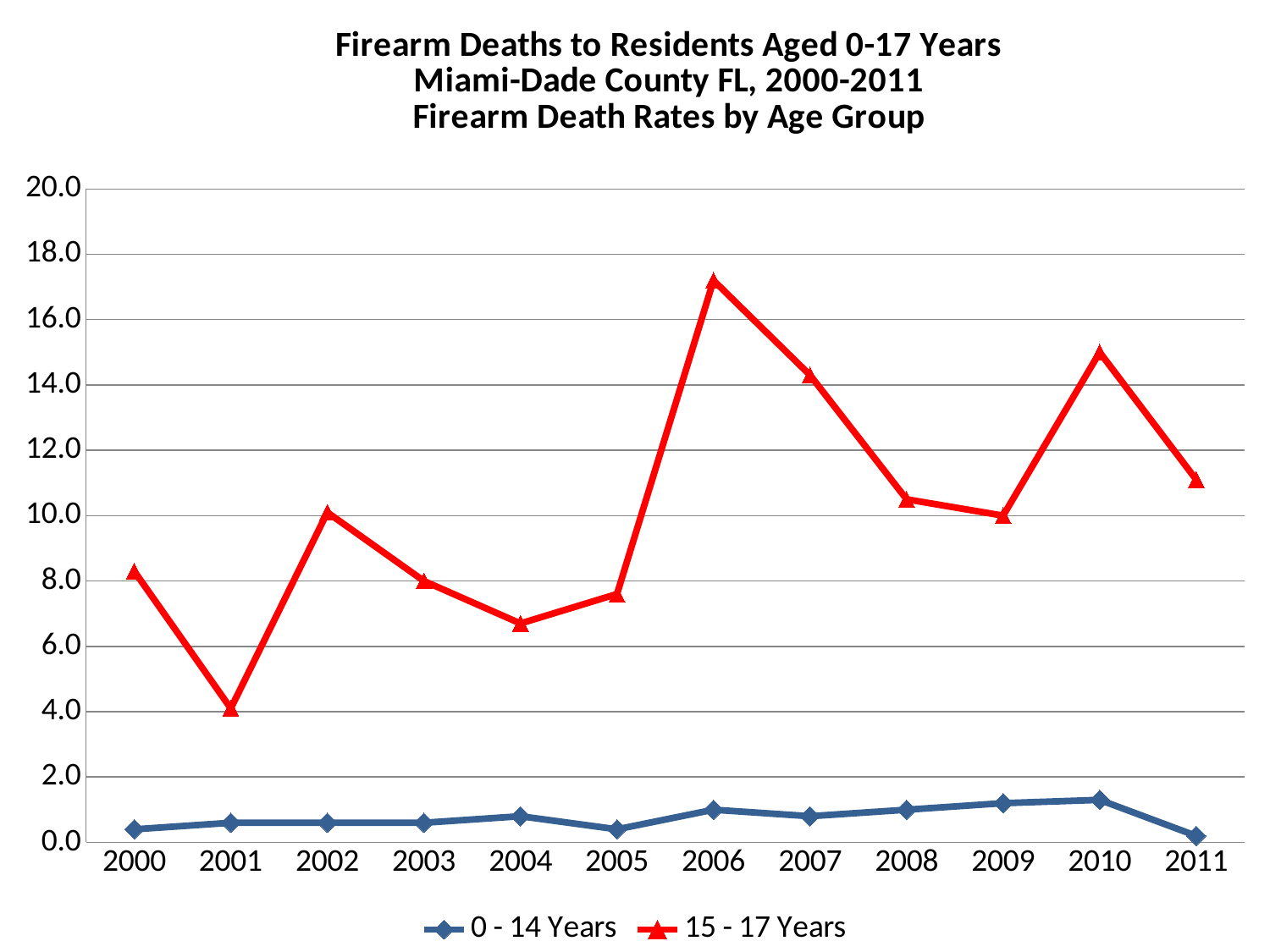
How many years are plotted along the x axis? 12 Which year has the larger value for 15 - 17 Years, 2006 or 2007? 2006 Is the value for 15 - 17 Years in 2010 greater or less than 14.0? greater Is the value for 15 - 17 Years in 2001 greater or less than 6.0? less Which series is drawn in red? 15 - 17 Years What kind of chart is shown on the slide? line chart How many series does the legend list? 2 In which year is the firearm death rate for 15 - 17 Years highest? 2006 Is the value for 15 - 17 Years in 2006 greater or less than 16.0? greater In which year is the firearm death rate for 15 - 17 Years lowest? 2001 Does the 15 - 17 Years line rise or fall from 2006 to 2009? fall